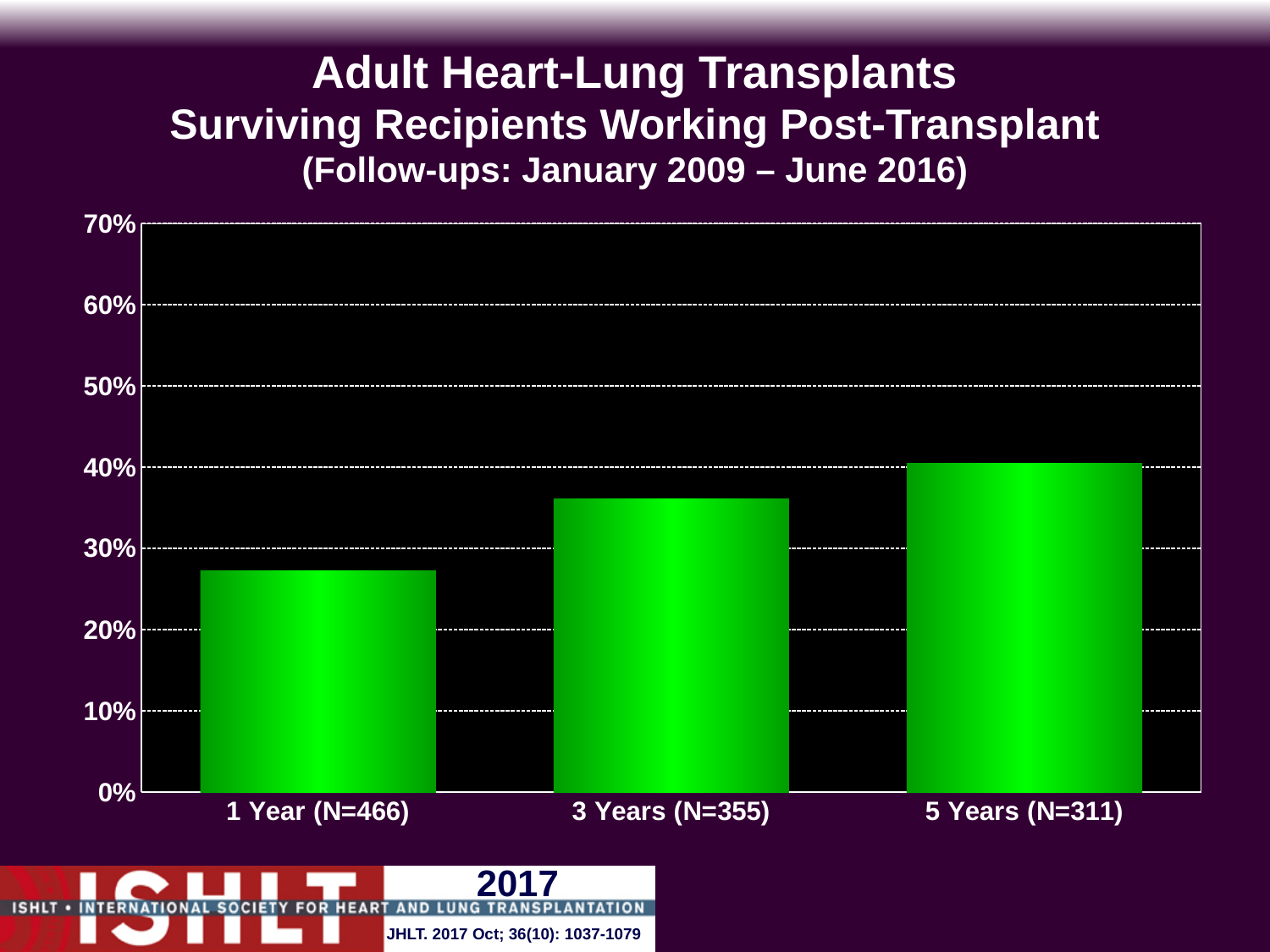
Which category has the highest percentage of surviving recipients working post-transplant? 5 Years (N=311) Is the value for 1 Year (N=466) greater or less than 20%? greater How many categories are plotted on the x axis? 3 Is the value for 5 Years (N=311) greater or less than 50%? less Is the value for 3 Years (N=355) greater or less than 30%? greater What follow-up period does the chart title state? January 2009 – June 2016 Which is larger, the value for 3 Years (N=355) or the value for 1 Year (N=466)? 3 Years (N=355) What kind of chart is shown on the slide? bar chart Which category has the lowest percentage of surviving recipients working post-transplant? 1 Year (N=466) Do the values rise or fall from 1 Year to 5 Years along the x axis? rise